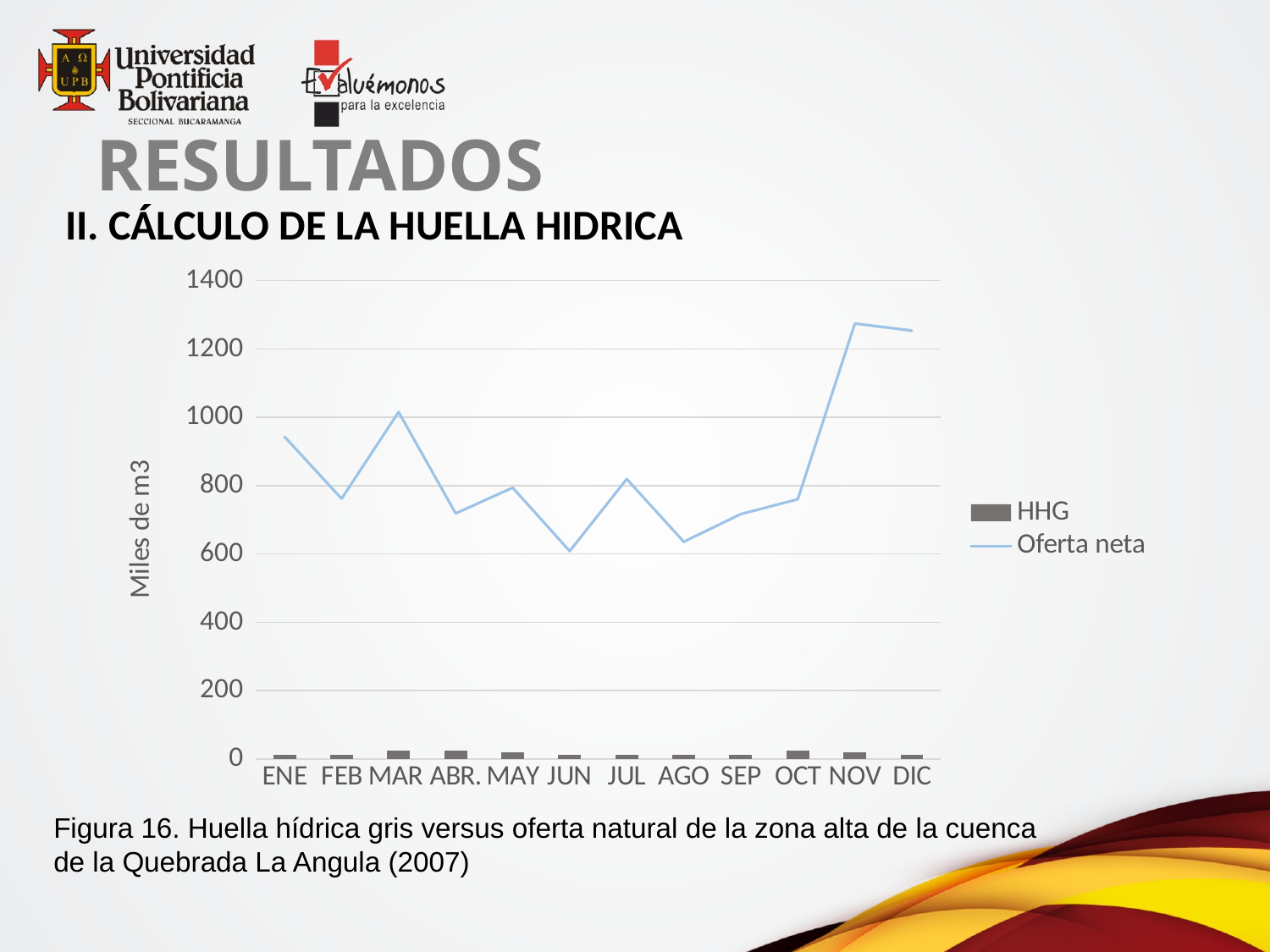
Is the HHG value for MAR greater or less than 200? less What is the label of the vertical axis? Miles de m3 What kind of chart is this? A combined bar and line chart Does the Oferta neta line rise or fall from OCT to NOV? rise How many series does the legend list? 2 What are the two series named in the legend? HHG and Oferta neta How many months are shown along the x axis? 12 Is the Oferta neta value for ENE greater or less than 800? greater Is the Oferta neta value for JUN greater or less than 800? less Which has a higher Oferta neta value, NOV or ENE? NOV